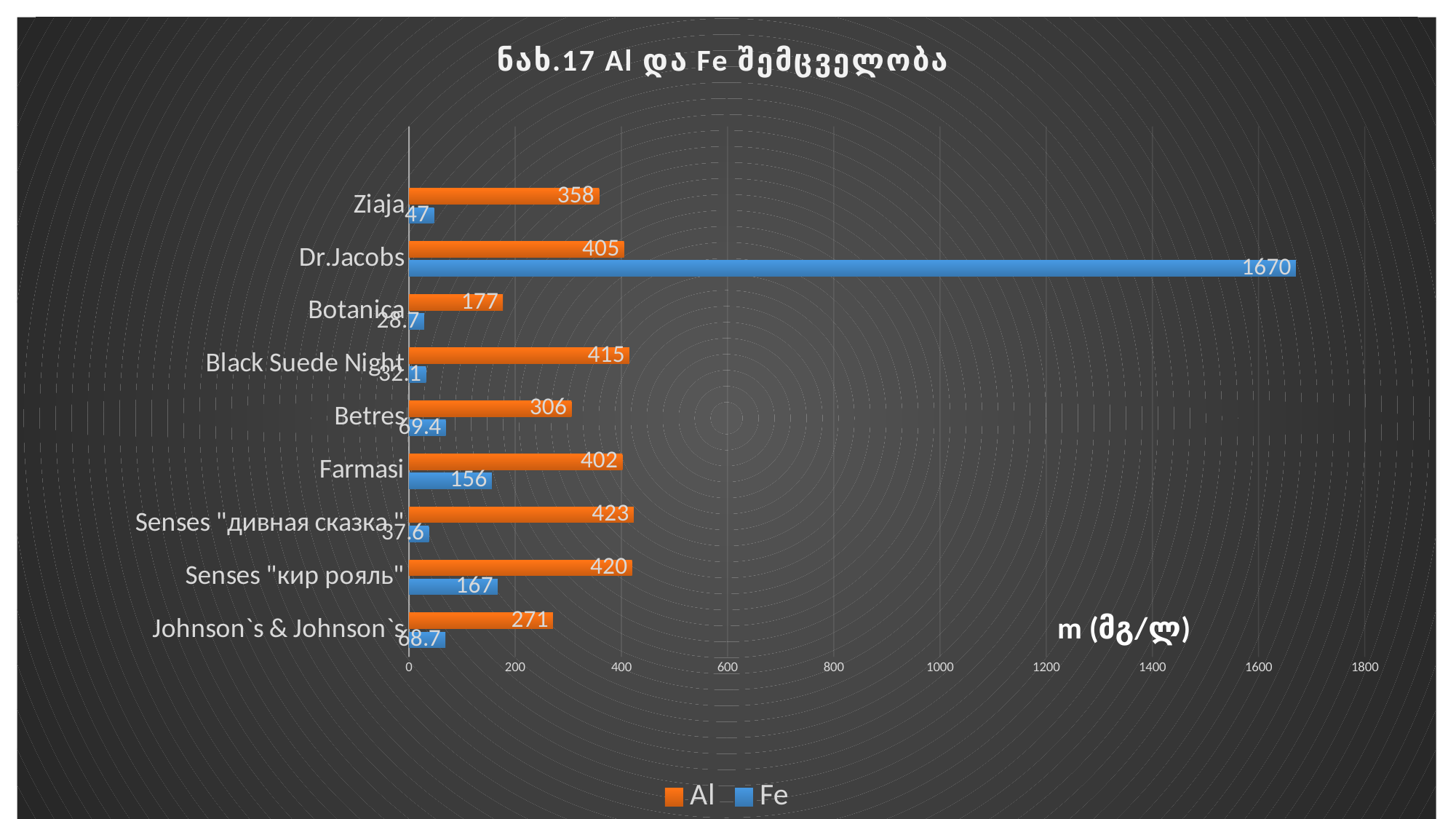
What is the Al value for Botanica? 177 Is the Fe value for Dr.Jacobs greater or less than 1600? greater How many series does the legend list? 2 What is the difference between the Fe and Al values for Dr.Jacobs? 1265 What is the Fe value for Farmasi? 156 Which category has the lowest Al value? Botanica How many product categories are plotted on the chart? 9 Which is larger: the Al value for Ziaja or the Al value for Betres? Ziaja What type of chart is shown on the slide? bar chart What is the Fe value for Dr.Jacobs? 1670 Which series is shown in orange in the legend? Al Which category has the highest Fe value? Dr.Jacobs